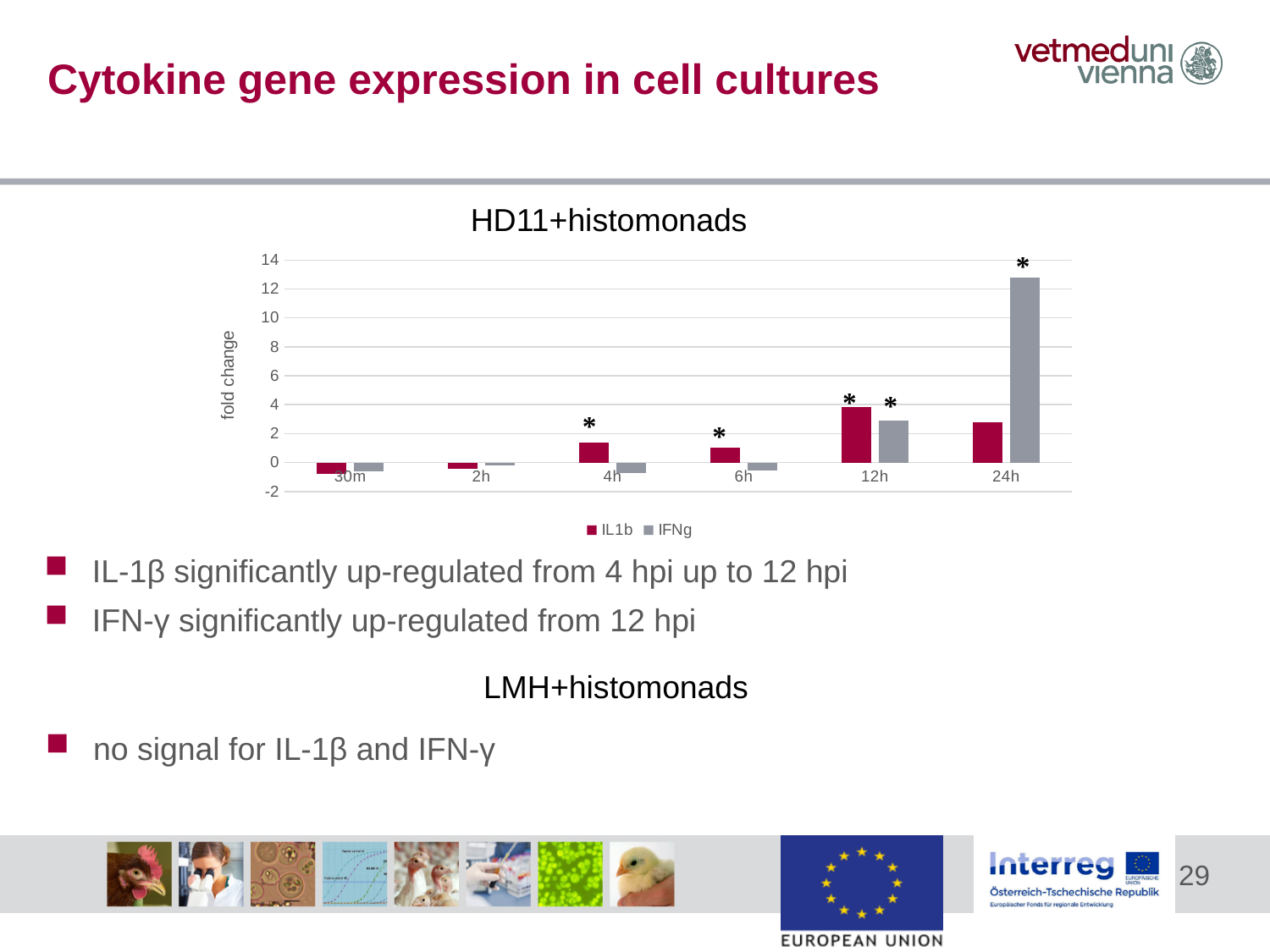
What kind of chart is shown on the slide? bar chart At which time point is the IFNg value highest? 24h What is the label of the y axis of the chart? fold change How many series does the chart's legend list? 2 Does the IFNg value rise or fall from 12h to 24h? rise At 24h, which series has the larger value, IL1b or IFNg? IFNg Is the IL1b value at 12h greater or less than 2? greater Is the IFNg value at 24h greater or less than 10? greater At which time point is the IL1b value highest? 12h Is the IFNg value at 4h greater or less than 0? less How many time-point categories are shown on the x axis of the chart? 6 What is the title of the chart? HD11+histomonads